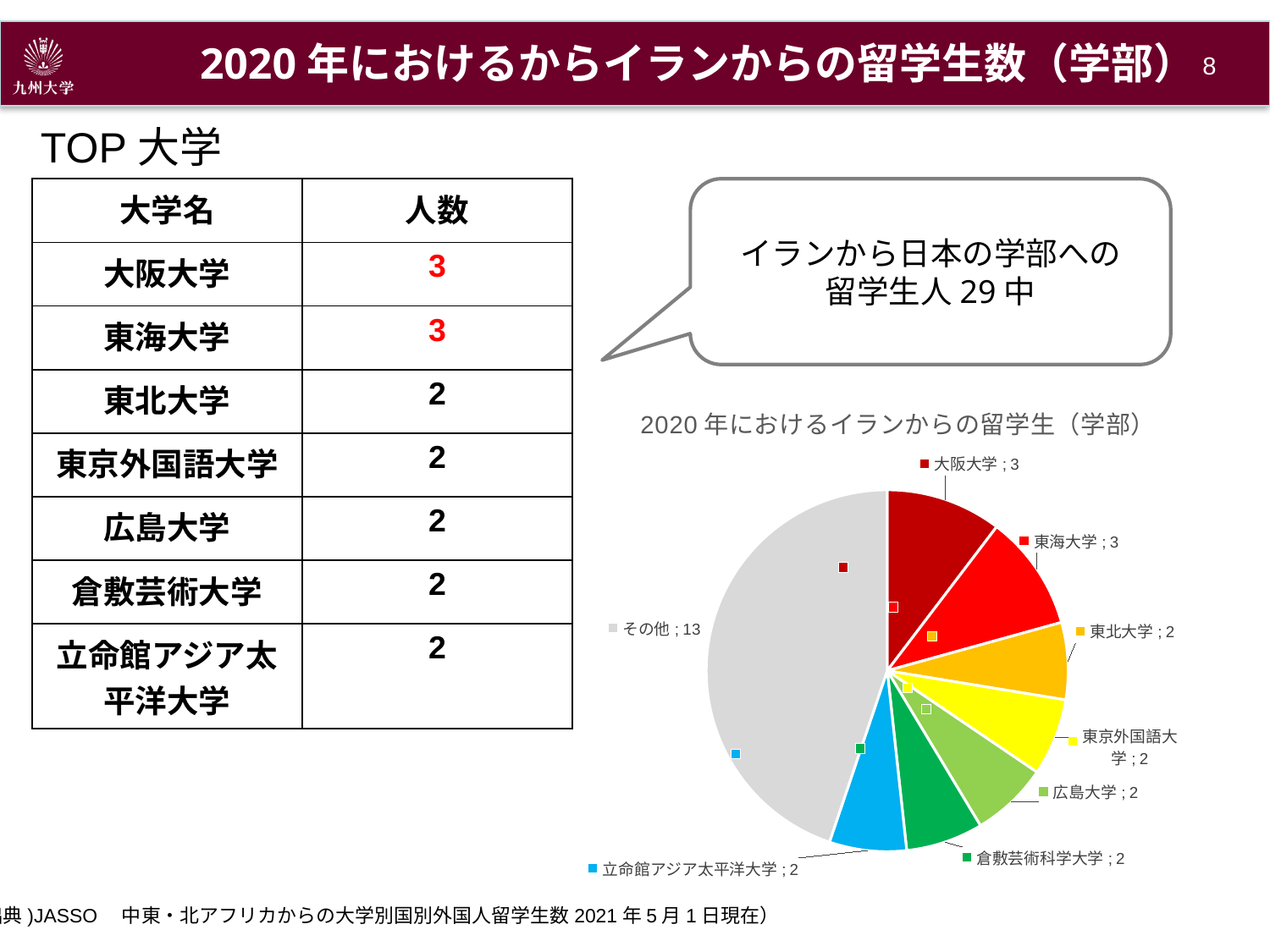
How many slices does the pie chart have? 8 What is the total of all slices in the pie chart? 29 In the pie chart, what is the value for 大阪大学? 3 What kind of chart is shown on the slide? pie chart In the pie chart, what is the value for 東海大学? 3 In the pie chart, what is the difference between the value for その他 and the value for 大阪大学? 10 In the pie chart, what is the value for その他? 13 Which slice of the pie chart has the largest value? その他 In the pie chart, which is larger: the value for 東海大学 or the value for 東北大学? 東海大学 In the pie chart, what is the value for 立命館アジア太平洋大学? 2 What is the title of the pie chart? 2020年におけるイランからの留学生（学部） In the pie chart, what is the value for 広島大学? 2